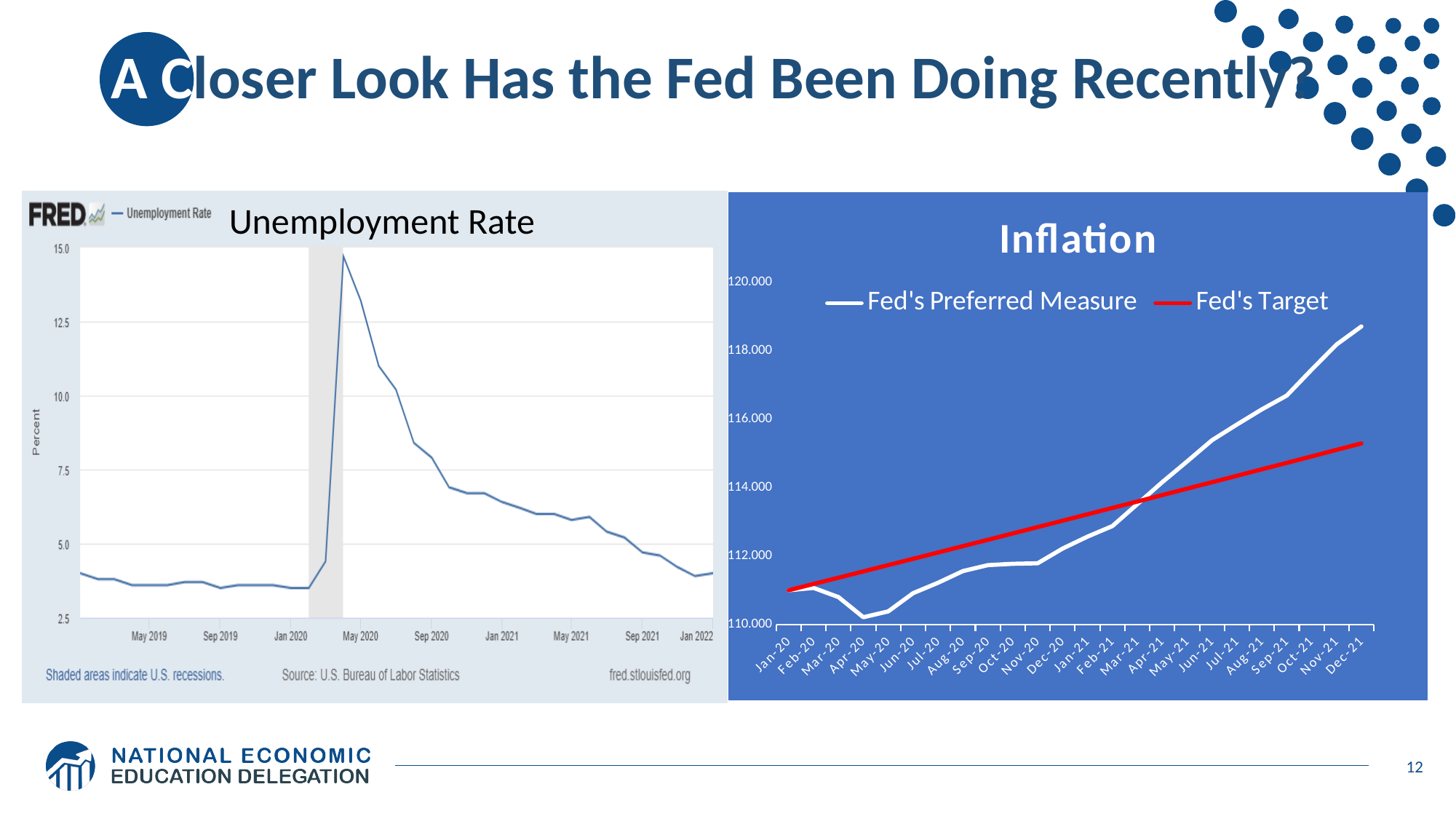
How many series does the legend of the Inflation chart list? 2 In the Unemployment Rate chart, does the unemployment rate rise or fall from May 2020 to Jan 2022? fall In the Inflation chart, which series has the higher value in Dec-21, Fed's Preferred Measure or Fed's Target? Fed's Preferred Measure In the Inflation chart, is the value of Fed's Target for Dec-21 greater or less than 114.000? greater In the Unemployment Rate chart, is the peak value in 2020 greater or less than 12.5? greater What kind of chart is the Inflation chart? line chart In the Inflation chart, is the value of Fed's Preferred Measure for Apr-20 greater or less than 112.000? less In the Inflation chart, does Fed's Target rise or fall from Jan-20 to Dec-21? rise What kind of chart is the Unemployment Rate chart? line chart What are the two series named in the legend of the Inflation chart? Fed's Preferred Measure and Fed's Target How many months are labelled on the x axis of the Inflation chart? 24